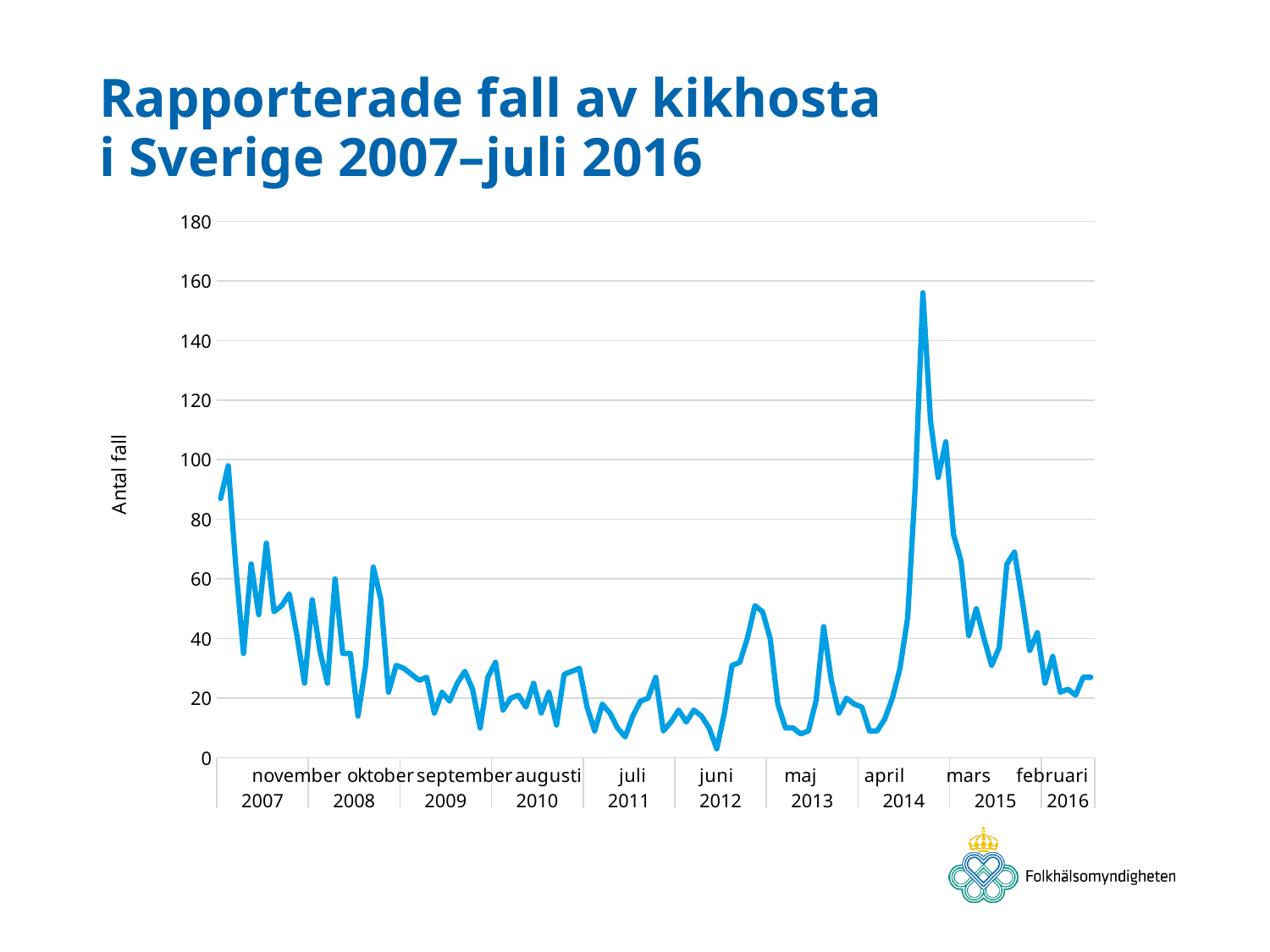
In which year does the line reach its highest peak? 2014 What is the label on the vertical axis of the chart? Antal fall What is the title of the chart on the slide? Rapporterade fall av kikhosta i Sverige 2007–juli 2016 Is the lowest point of the line, around 2012, greater or less than 20? less What kind of chart is shown on the slide? line chart Does the line generally rise or fall from the start of 2007 to 2009? fall Which is higher: the peak of the line in 2014 or the peak in 2007? 2014 Is the peak of the line in 2012 greater or less than 40? greater Is the highest peak of the line, in 2014, greater or less than 140? greater How many years are labelled along the x axis? 10 What is the highest value shown on the vertical axis? 180